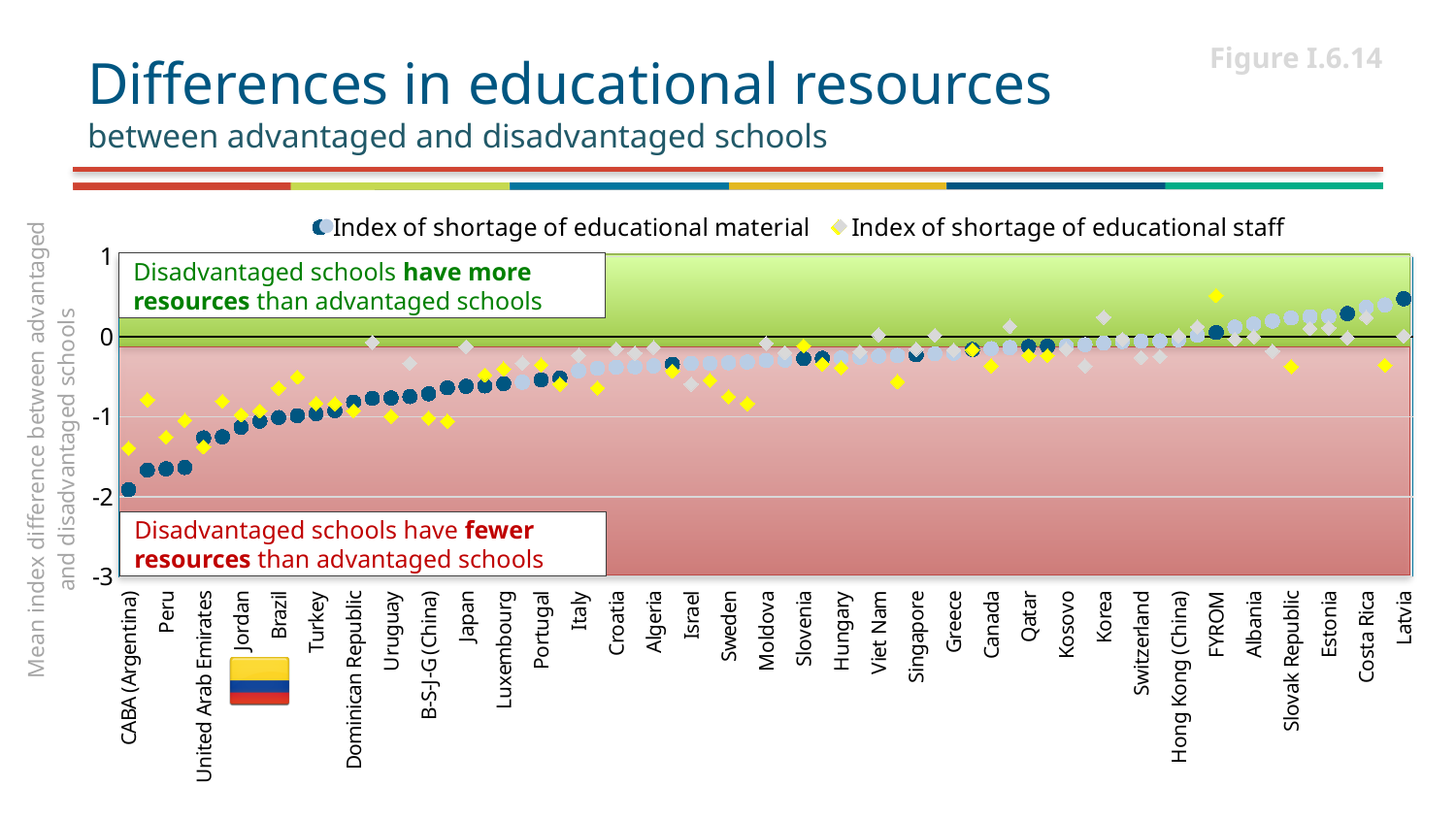
What kind of chart is shown on the slide? scatter chart For Peru, which is larger: the Index of shortage of educational material or the Index of shortage of educational staff? Index of shortage of educational staff Which country has the lowest value for the Index of shortage of educational material? CABA (Argentina) Do the values for the Index of shortage of educational material rise or fall from left to right along the x axis? rise Is the Index of shortage of educational material for Latvia greater or less than 0? greater Which country has the highest value for the Index of shortage of educational material? Latvia Is the Index of shortage of educational material for CABA (Argentina) greater or less than -1? less Is the Index of shortage of educational material for Japan greater or less than -1? greater How many series does the legend list? 2 Which country has the larger Index of shortage of educational material, CABA (Argentina) or Latvia? Latvia What is the figure number shown on the slide? Figure I.6.14